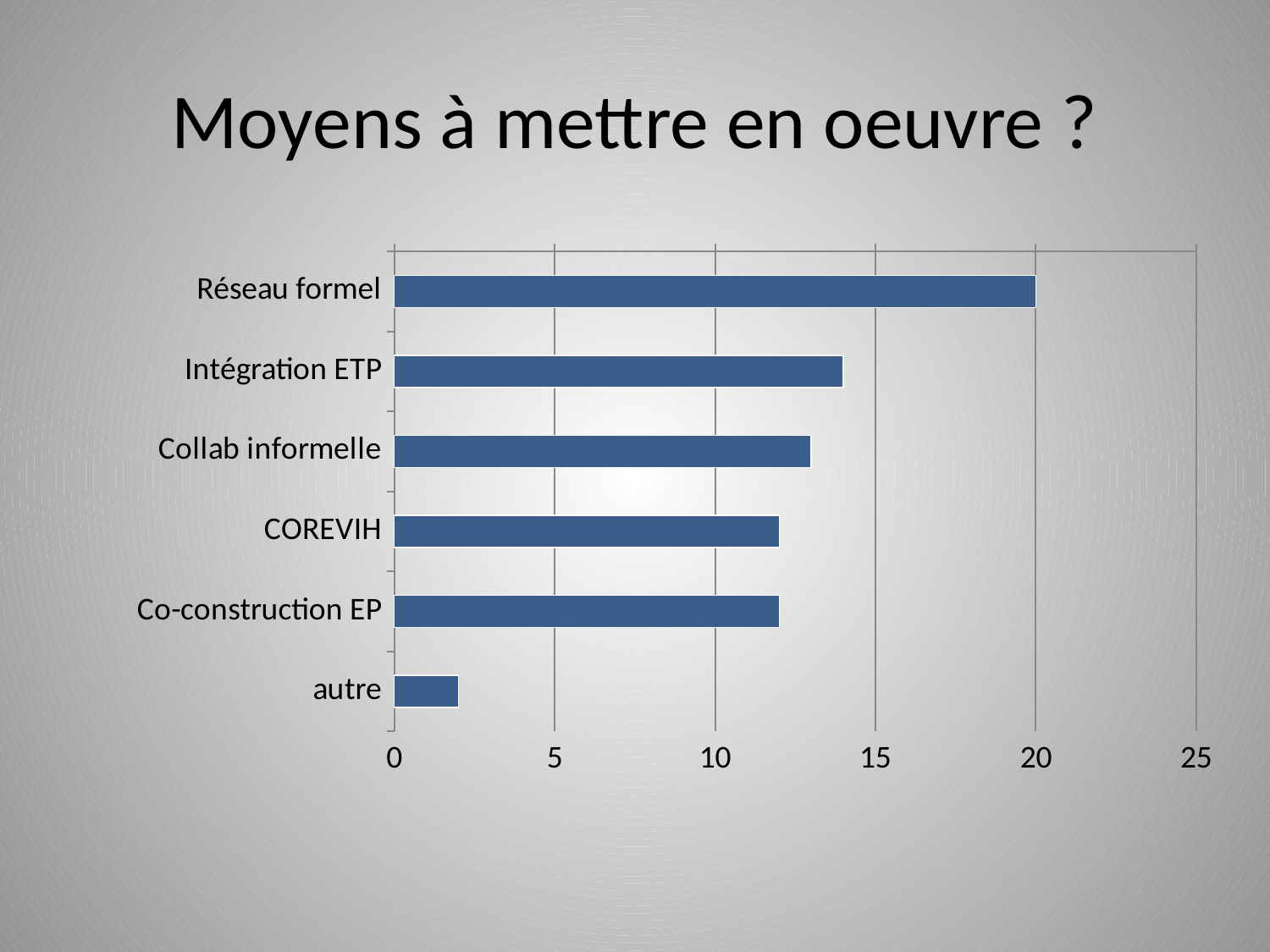
Which is larger, the value for autre or the value for Co-construction EP? Co-construction EP Which category has the lowest value? autre What type of chart is shown on the slide? bar chart Is the value for autre greater or less than 5? less Is the value for COREVIH greater or less than 10? greater Is the value for Collab informelle greater or less than 15? less What is the value for Réseau formel? 20 Which is larger, the value for Réseau formel or the value for Intégration ETP? Réseau formel Which category has the highest value? Réseau formel What is the title of the slide? Moyens à mettre en oeuvre ? How many categories are shown in the chart? 6